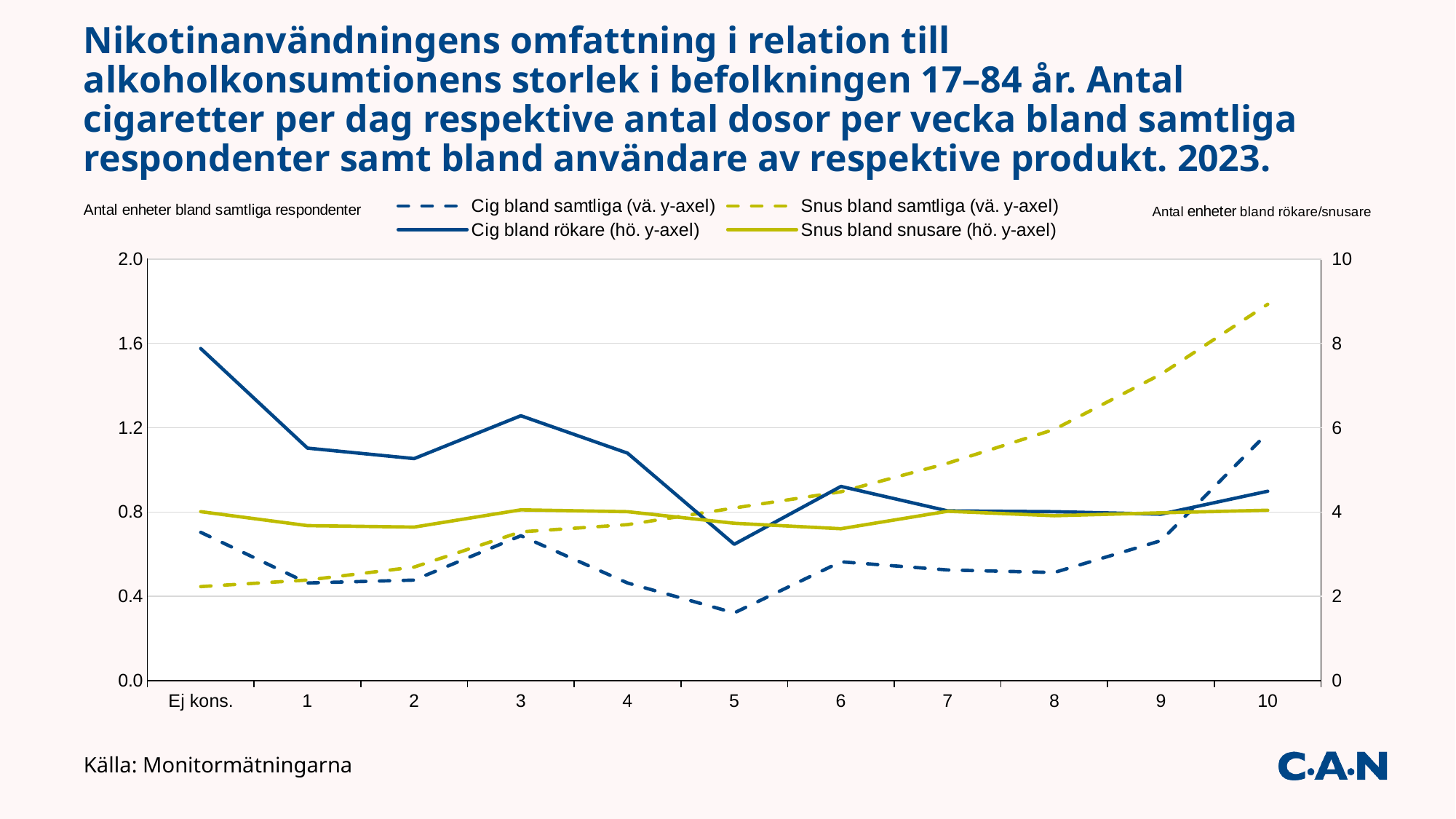
Is the value for 'Cig bland rökare (hö. y-axel)' at 5 greater or less than 4 on the right y axis? less What kind of chart is shown on the slide? Line chart What is the source given below the chart? Monitormätningarna Is the value for 'Cig bland rökare (hö. y-axel)' at 'Ej kons.' greater or less than 6 on the right y axis? greater How many series does the legend list? 4 Is the value for 'Snus bland samtliga (vä. y-axel)' at 10 greater or less than 1.6 on the left y axis? greater Does the 'Snus bland samtliga (vä. y-axel)' series generally rise or fall from 'Ej kons.' to 10? Rise At which x-axis category does 'Snus bland samtliga (vä. y-axel)' reach its highest value? 10 How many categories are shown on the x axis? 11 At which x-axis category does 'Cig bland samtliga (vä. y-axel)' reach its lowest value? 5 At 'Ej kons.', which is larger: 'Cig bland samtliga (vä. y-axel)' or 'Snus bland samtliga (vä. y-axel)'? Cig bland samtliga (vä. y-axel)